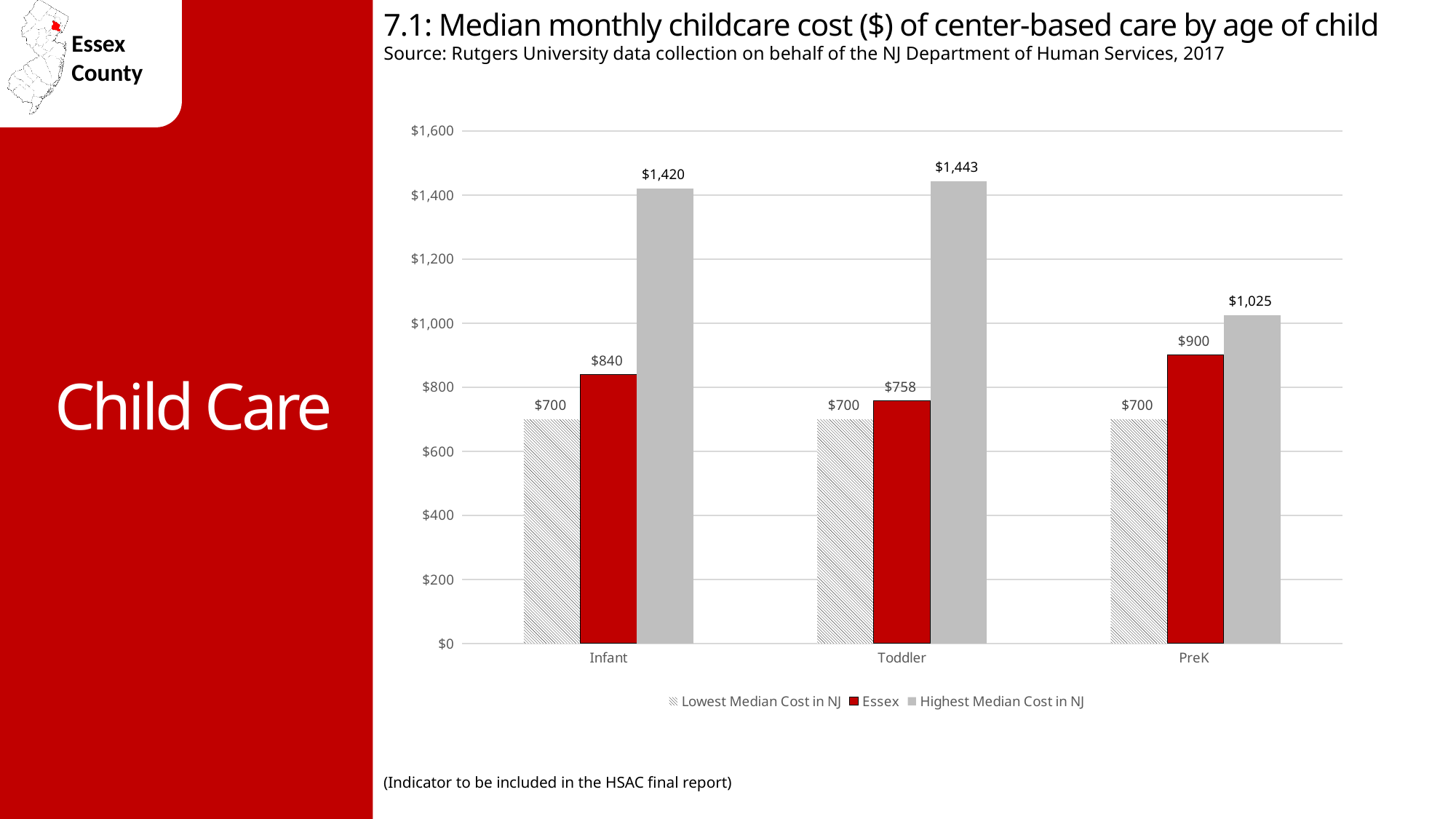
How many age groups are shown on the x axis? 3 Which age group has the lowest Highest Median Cost in NJ? PreK What is the Highest Median Cost in NJ for Toddler care? $1,443 What is the median monthly childcare cost for Essex for Infant care? $840 Which age group has the highest Essex median monthly cost? PreK What kind of chart is shown on the slide? bar chart Is the Essex cost for Toddler care larger or smaller than the Essex cost for PreK care? smaller What is the difference between the Highest Median Cost in NJ and the Essex cost for Infant care? $580 What is the Lowest Median Cost in NJ for PreK care? $700 How many series does the legend list? 3 Which series is drawn in red? Essex Is the Highest Median Cost in NJ for PreK greater or less than $1,200? less